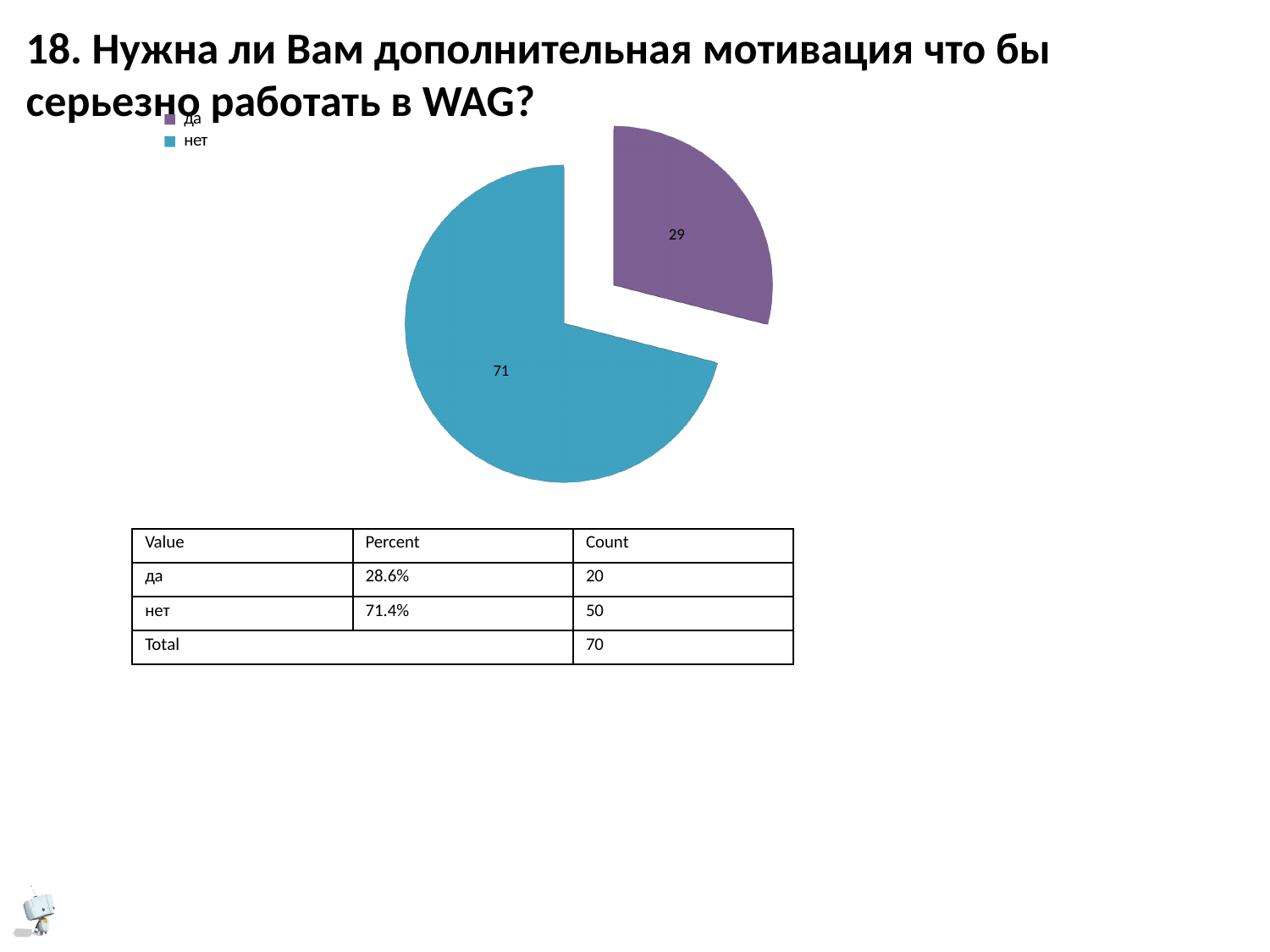
What value is printed on the "нет" slice of the pie chart? 71 How many slices does the pie chart have? 2 What is the difference between the values printed on the "нет" and "да" slices? 42 What colour is the "нет" slice of the pie chart? blue Which slice of the pie chart is the largest? нет What value is printed on the "да" slice of the pie chart? 29 What colour is the "да" slice of the pie chart? purple What kind of chart is shown on the slide? pie chart Which slice is larger in the pie chart, "да" or "нет"? нет How many entries does the legend of the pie chart list? 2 Which slice of the pie chart is the smallest? да